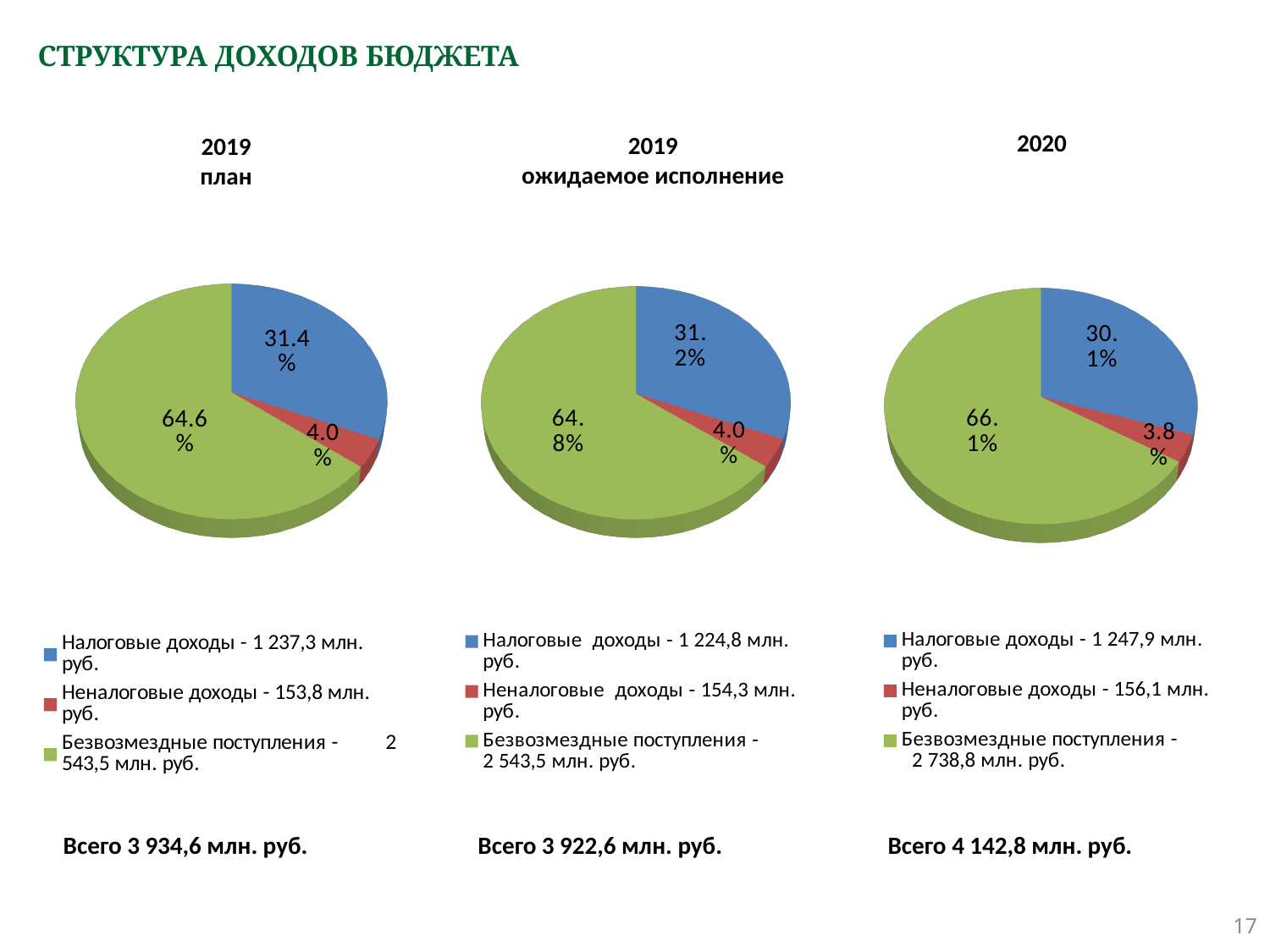
In the "2019 план" chart, what share of the pie is labelled for Налоговые доходы? 31.4% In the "2019 ожидаемое исполнение" chart, what share of the pie is labelled for Неналоговые доходы? 4.0% In the "2020" chart, which category has the largest slice? Безвозмездные поступления In the "2019 ожидаемое исполнение" chart, what share of the pie is labelled for Безвозмездные поступления? 64.8% How many slices does the "2019 ожидаемое исполнение" pie chart have? 3 In the "2020" chart, what colour is the slice for Безвозмездные поступления? green In the "2020" chart, what is the difference between the shares of Безвозмездные поступления and Налоговые доходы? 36.0% In the "2019 план" chart, which category has the smallest slice? Неналоговые доходы What kind of chart is used for the "2019 план" chart? pie chart